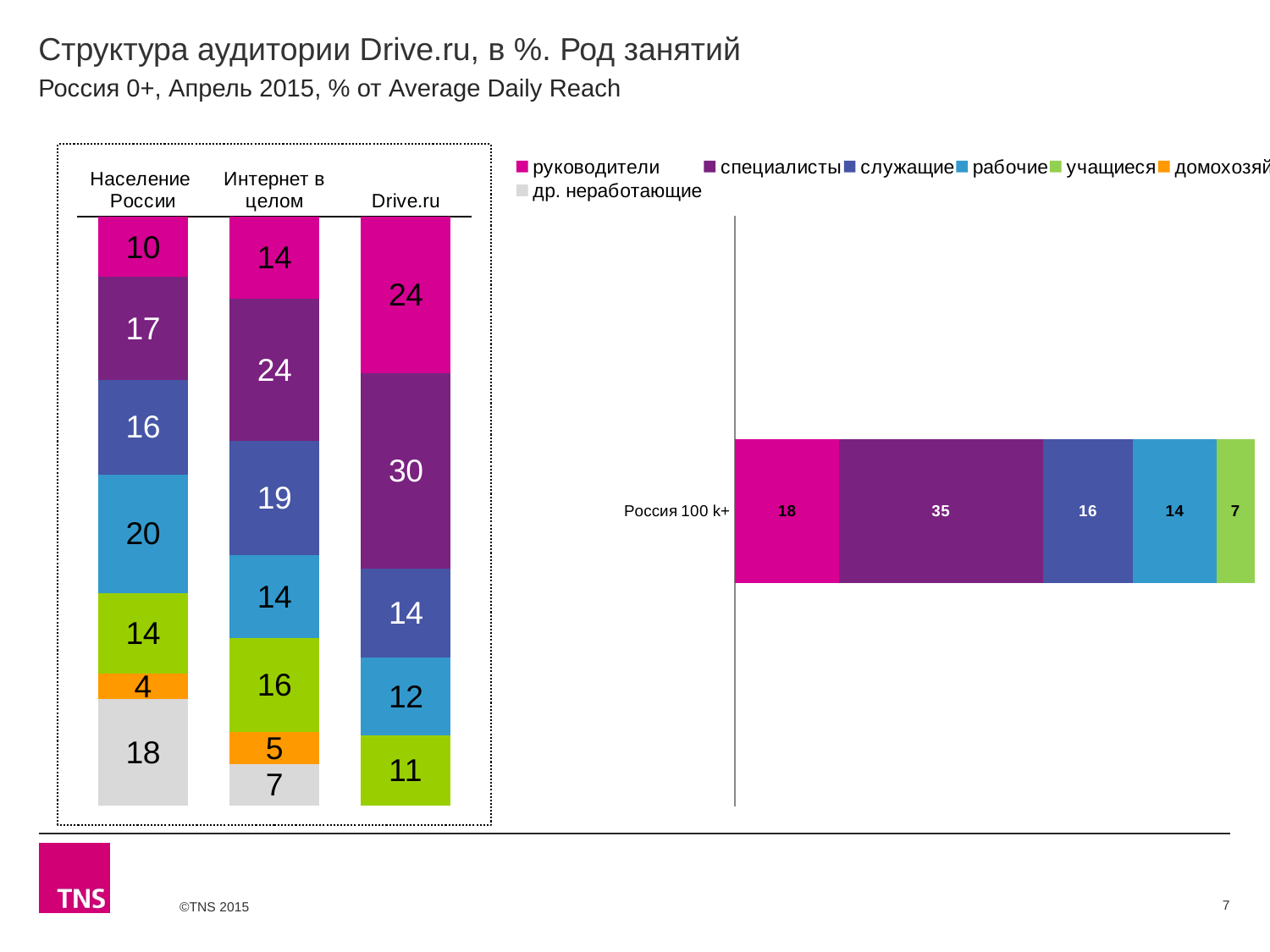
In the left stacked bar chart, what is the value of the grey bottom segment for Население России? 18 In the left stacked bar chart, what is the value of the top (pink) segment for Drive.ru? 24 In the Россия 100 k+ chart on the right, which category has the smallest value? учащиеся How many entries does the legend on the right list? 7 In the left stacked bar chart, what is the total of the Drive.ru bar? 91 In the left stacked bar chart, how many segments make up the Drive.ru bar? 5 In the left stacked bar chart, is the orange segment larger for Население России or for Интернет в целом? Интернет в целом In the Россия 100 k+ chart on the right, what is the value for специалисты? 35 In the left stacked bar chart, what is the value of the purple segment for Интернет в целом? 24 In the left stacked bar chart, which of the three bars has the largest purple segment? Drive.ru In the Россия 100 k+ chart on the right, what is the difference between специалисты and руководители? 17 In the left stacked bar chart, what is the difference between the pink segment for Drive.ru and the pink segment for Население России? 14